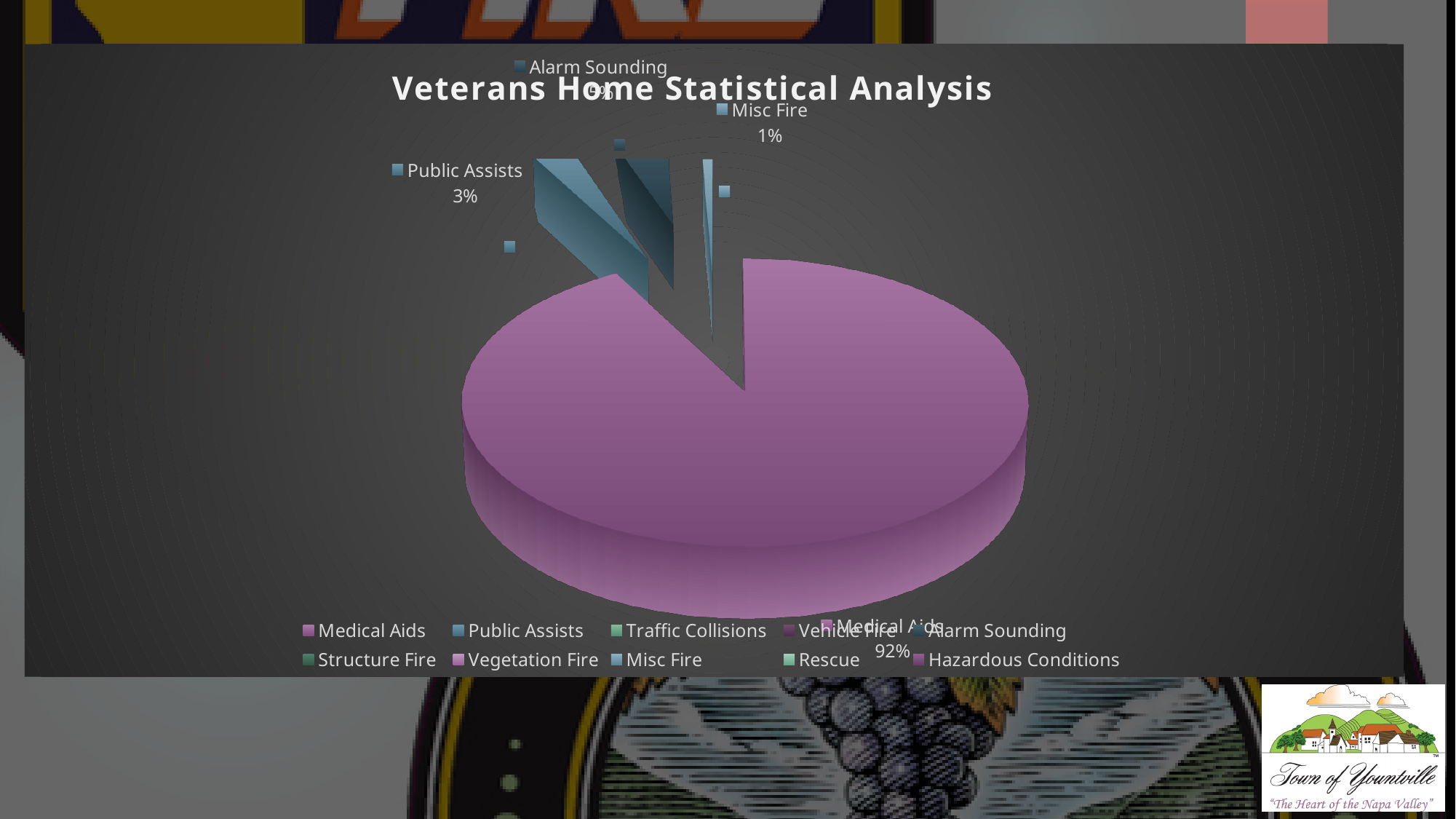
What kind of chart is shown on the slide? pie chart What is the title of the chart? Veterans Home Statistical Analysis What is the difference between the Medical Aids and Public Assists percentages? 89% What percentage is shown for Public Assists? 3% Which is larger, Public Assists or Misc Fire? Public Assists What share of the pie is Medical Aids? 92% Is the value for Medical Aids greater or less than 50%? greater Which category has the largest slice of the pie? Medical Aids What percentage is shown for Misc Fire? 1% What is the difference between the Public Assists and Misc Fire percentages? 2% How many categories does the legend list? 10